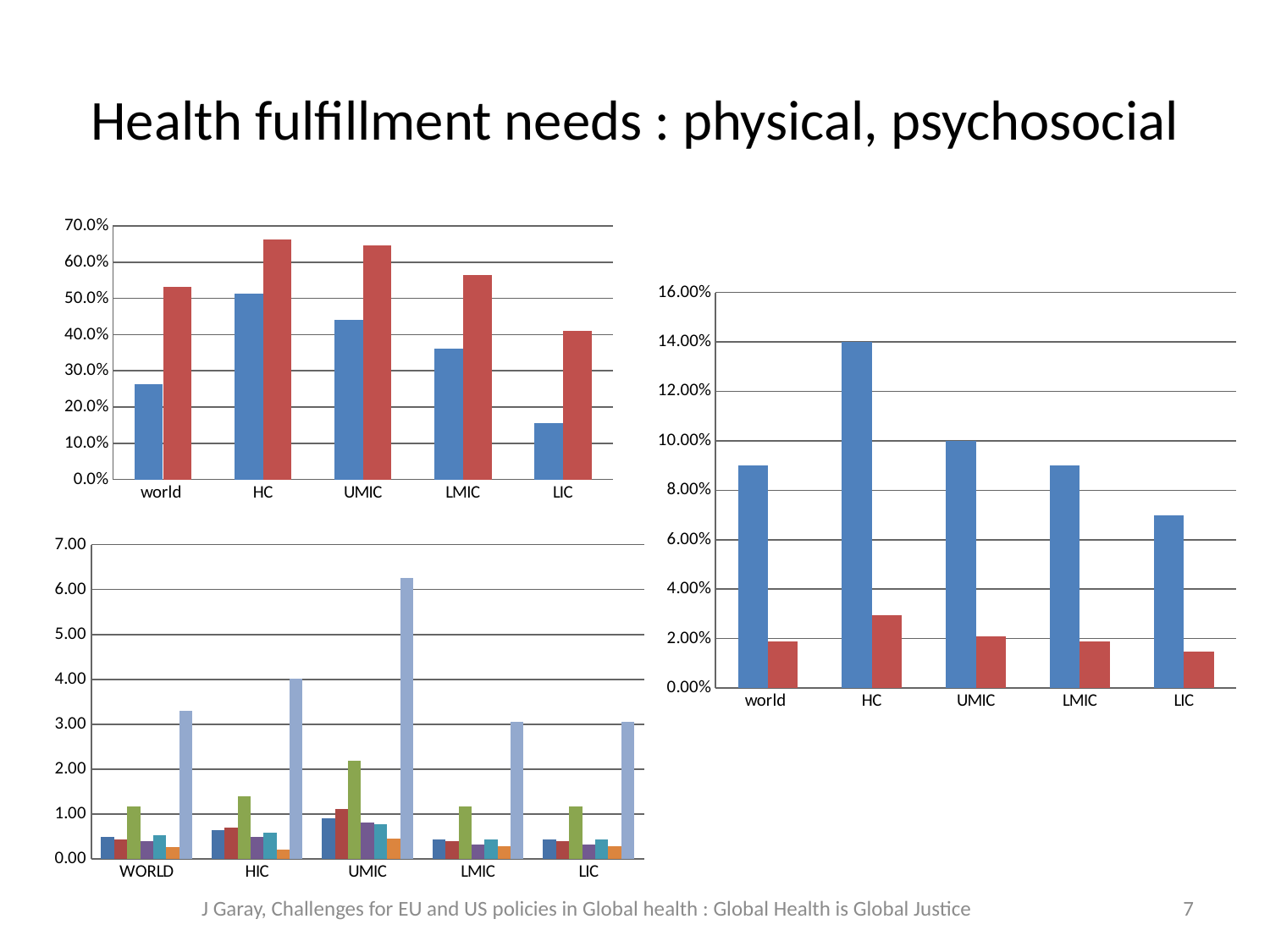
What kind of chart is the chart on the right side of the slide? bar chart In the top-left chart, which category has the highest blue bar? HC In the bottom-left chart, is the tallest bar for UMIC greater or less than 5.00? greater In the chart on the right, what is the value of the blue bar for HC? 14.00% How many categories are shown on the x axis of the top-left chart? 5 In the top-left chart, is the blue bar for LIC greater or less than 20.0%? less In the chart on the right, what is the value of the blue bar for UMIC? 10.00% In the top-left chart, which is larger for UMIC, the blue bar or the red bar? the red bar In the chart on the right, which category has the lowest blue bar? LIC In the top-left chart, which category has the lowest red bar? LIC In the chart on the right, which category has the highest blue bar? HC In the top-left chart, is the red bar for world greater or less than 50.0%? greater